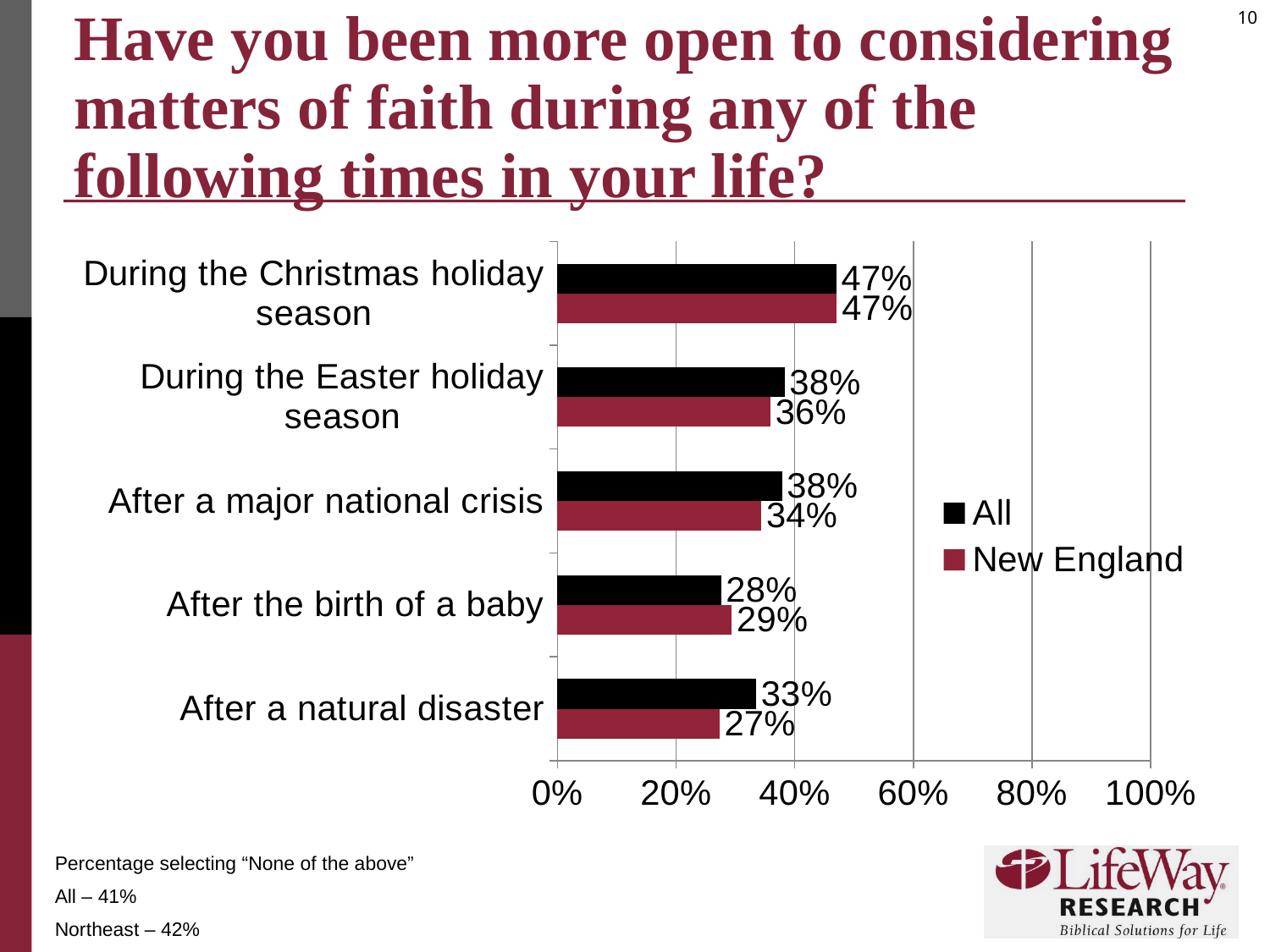
What is the New England value for 'After a major national crisis'? 34% How many series does the legend list? 2 What percentage of the All group said they were more open to considering matters of faith during the Christmas holiday season? 47% How many categories are shown on the chart? 5 What is the difference between the All and New England values for 'After a natural disaster'? 6% Which colour represents the New England series in the chart? Dark red What type of chart is shown on the slide? Bar chart Which category has the lowest value for the All series? After the birth of a baby Which category has the highest value for the New England series? During the Christmas holiday season For 'After the birth of a baby', which series has the larger value, All or New England? New England What is the New England value for 'After a natural disaster'? 27% What is the All value for 'After the birth of a baby'? 28%